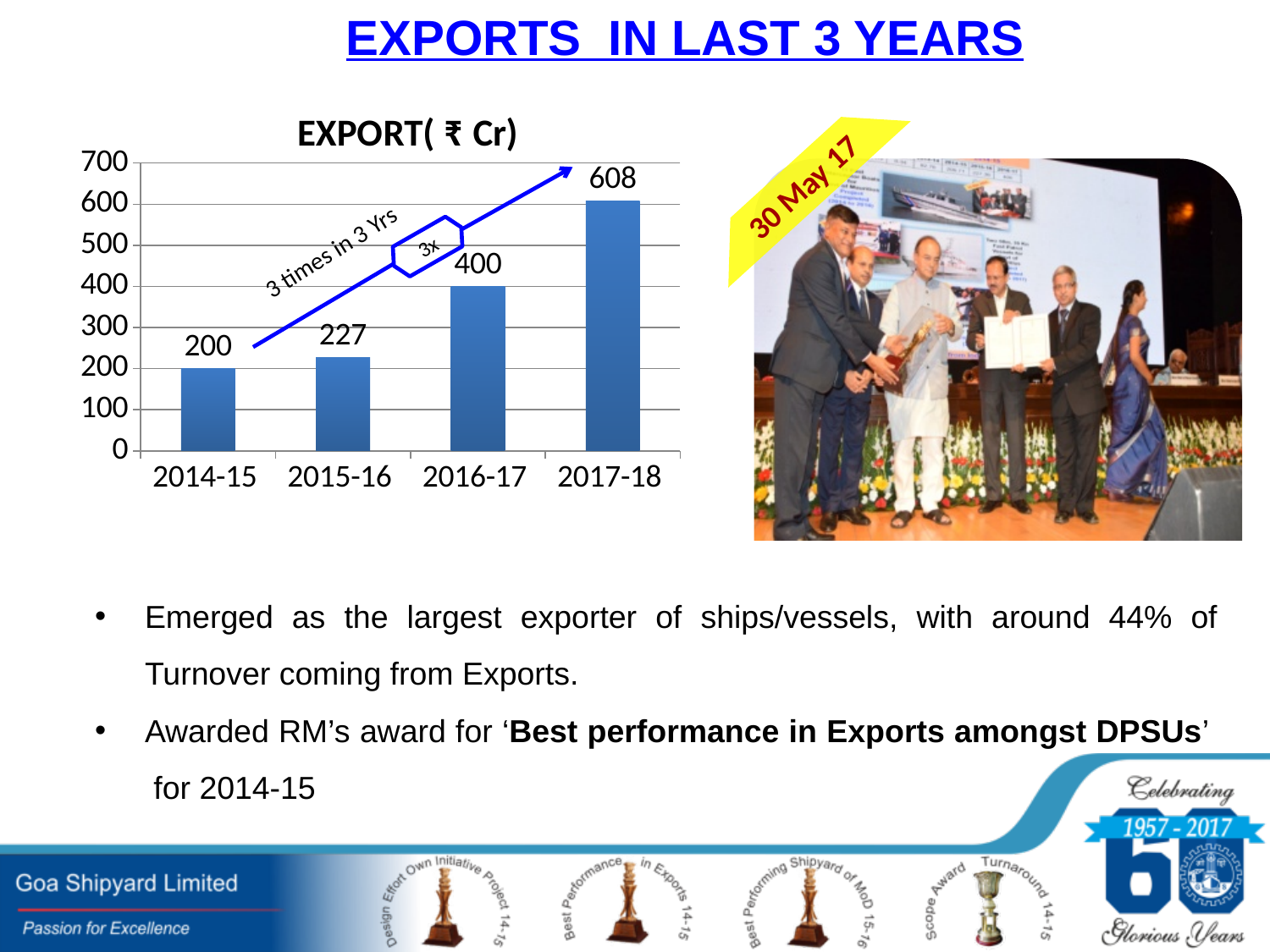
What is the export value for 2015-16? 227 Which year has the lowest export value? 2014-15 What is the title of the chart? EXPORT( ₹ Cr) Do the export values rise or fall from 2014-15 to 2017-18? Rise Which year has the highest export value? 2017-18 Which is larger, the export value for 2015-16 or for 2016-17? 2016-17 What is the export value for 2014-15? 200 What is the export value for 2016-17? 400 What kind of chart is shown? Bar chart What is the export value for 2017-18? 608 How many years are shown on the chart? 4 What is the difference between the export values for 2017-18 and 2016-17? 208